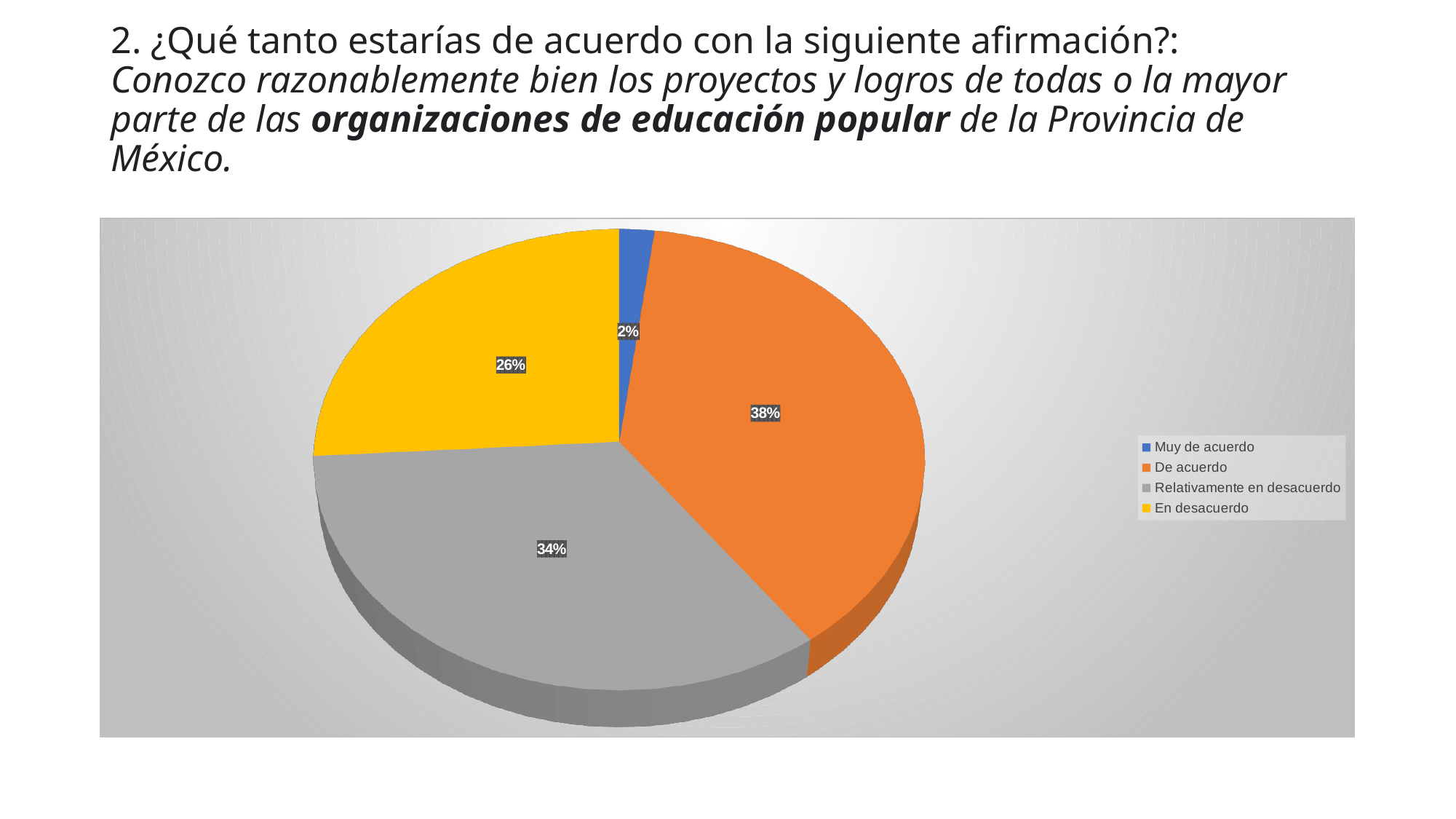
What is the difference in percentage points between "De acuerdo" and "En desacuerdo"? 12 Which response category has the largest share of the pie? De acuerdo What colour is the slice for "En desacuerdo"? Yellow Which response category has the smallest share of the pie? Muy de acuerdo What is the combined share of "Muy de acuerdo" and "De acuerdo"? 40% What kind of chart is shown on the slide? Pie chart What percentage of respondents answered "En desacuerdo"? 26% Which is larger, the share for "Relativamente en desacuerdo" or the share for "En desacuerdo"? Relativamente en desacuerdo What percentage of respondents answered "Muy de acuerdo"? 2% How many categories does the legend list? 4 What percentage of respondents answered "De acuerdo"? 38% What percentage of respondents answered "Relativamente en desacuerdo"? 34%